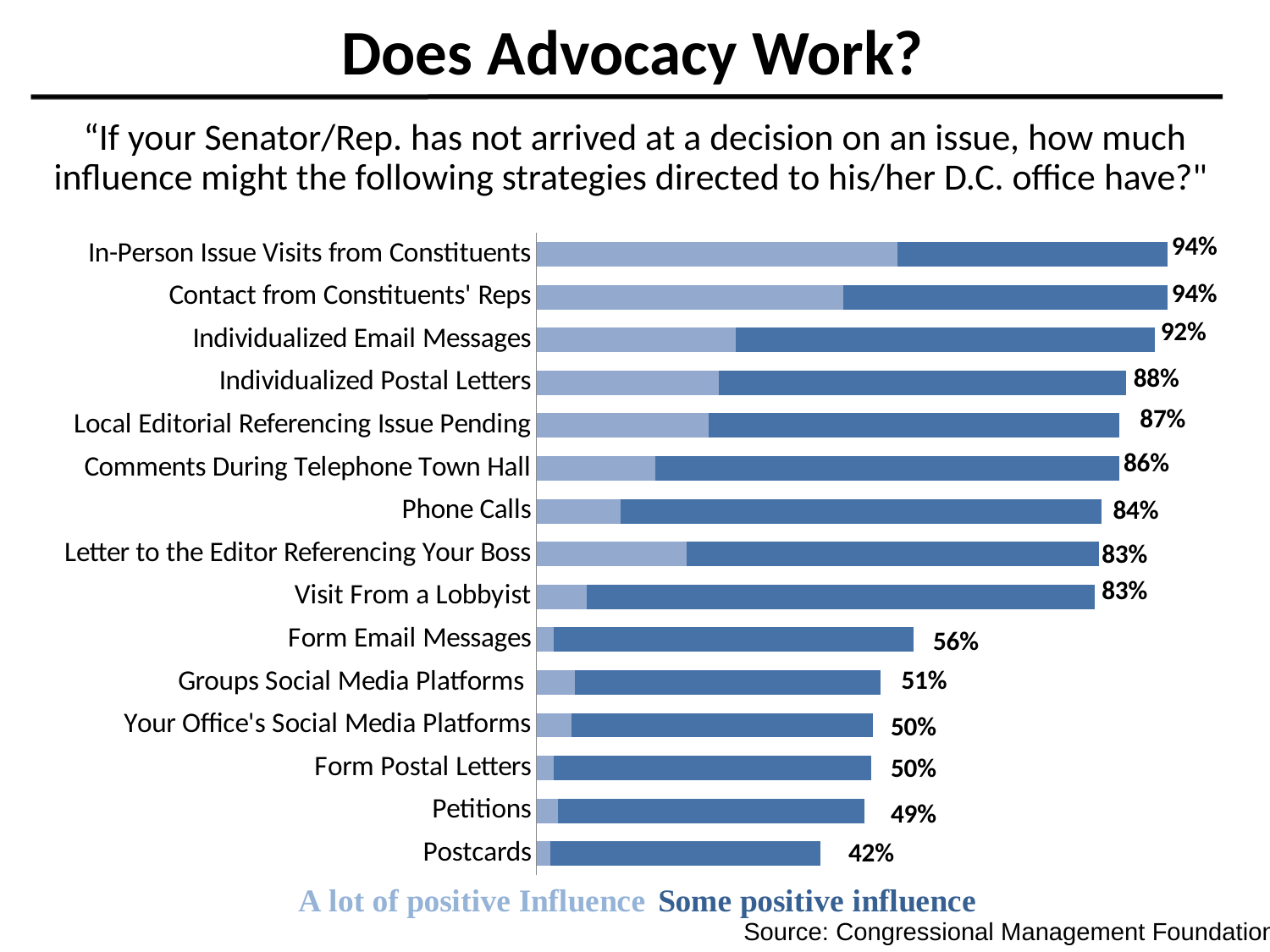
What is the total percentage shown for Postcards? 42% Which strategy has the lowest total percentage? Postcards Which has a higher total percentage, Phone Calls or Form Postal Letters? Phone Calls What is the total percentage shown for Individualized Postal Letters? 88% What kind of chart is shown on the slide? Stacked bar chart What is the difference in percentage points between In-Person Issue Visits from Constituents and Postcards? 52 percentage points What is the difference in percentage points between Form Email Messages and Petitions? 7 percentage points How many series does the legend list? 2 What is the total percentage shown for Form Email Messages? 56% Which has a higher total percentage, Individualized Email Messages or Individualized Postal Letters? Individualized Email Messages What is the total percentage shown for Phone Calls? 84% How many strategies (categories) are shown in the chart? 15